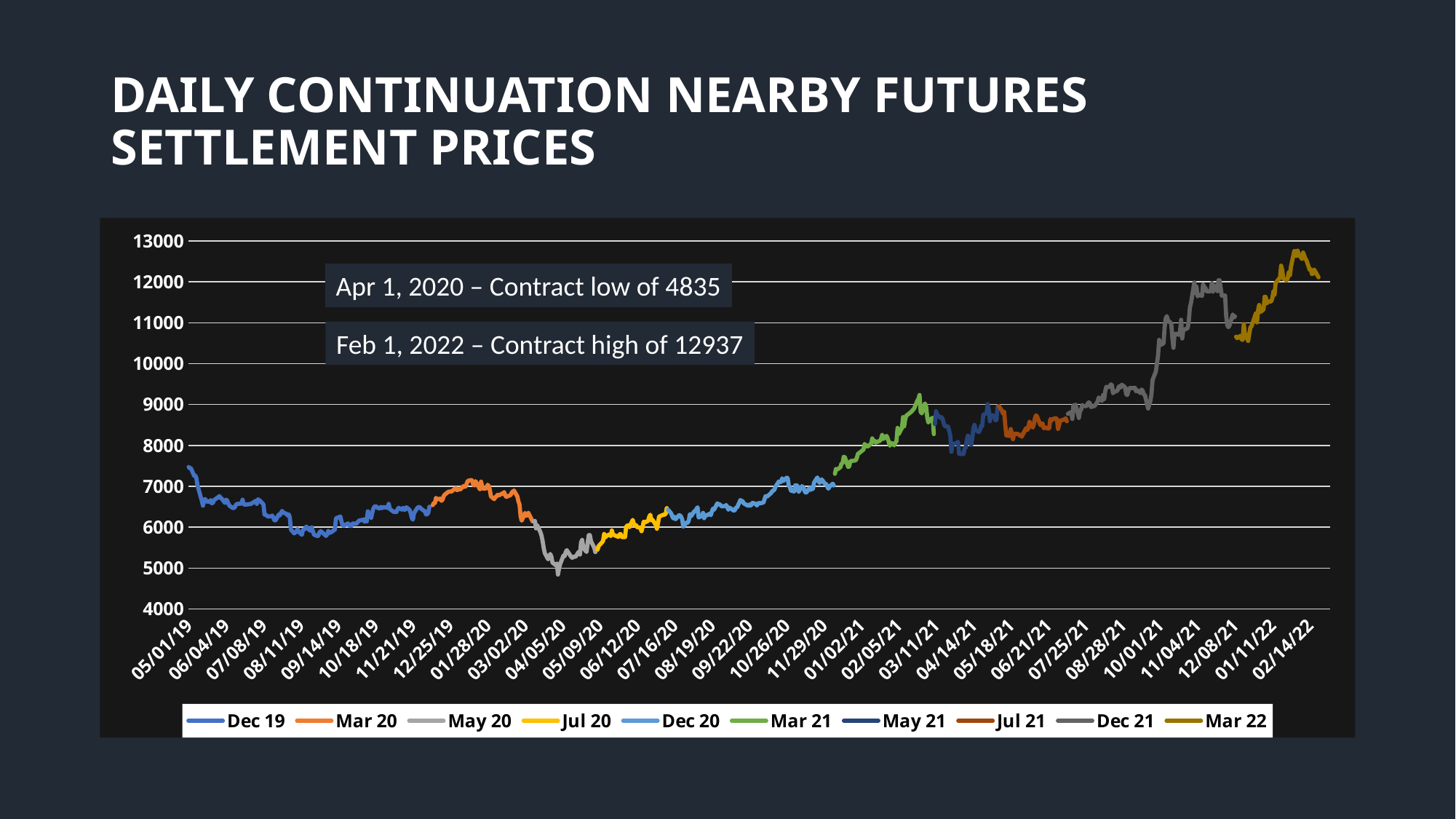
What is the difference between the contract high and the contract low noted on the chart? 8102 Which series contains the lowest point on the chart? May 20 What is the contract low value noted on the chart? 4835 On what date did the contract low of 4835 occur? Apr 1, 2020 What kind of chart is shown on the slide? line chart How many series does the legend list? 10 What is the title of the slide? Daily Continuation Nearby Futures Settlement Prices Which series reaches the highest prices on the chart? Mar 22 On what date did the contract high of 12937 occur? Feb 1, 2022 Is the peak value of the Mar 22 series greater or less than 12000? greater Overall, do prices rise or fall from 05/01/19 to 02/14/22? rise What is the contract high value noted on the chart? 12937